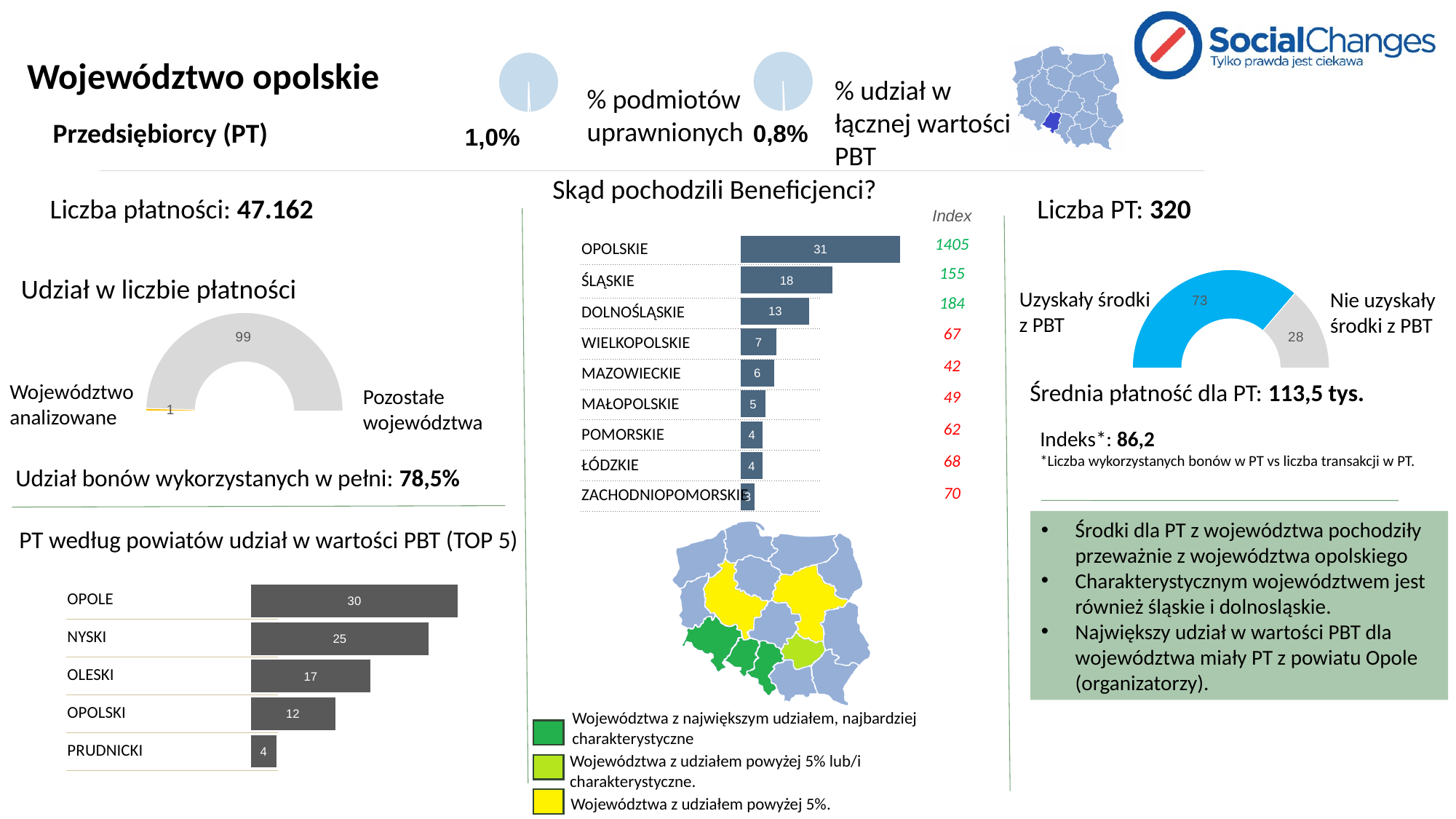
In the 'Skąd pochodzili Beneficjenci?' chart, what is the Index value shown for OPOLSKIE? 1405 In the doughnut chart under 'Liczba PT: 320', what is the value for 'Uzyskały środki z PBT'? 73 In the 'Skąd pochodzili Beneficjenci?' chart, what is the difference between the values for ŚLĄSKIE and DOLNOŚLĄSKIE? 5 In the 'Skąd pochodzili Beneficjenci?' chart, which voivodeship has the highest value? OPOLSKIE In the 'Skąd pochodzili Beneficjenci?' chart, how many voivodeships are listed? 9 In the 'Skąd pochodzili Beneficjenci?' chart, what is the value for OPOLSKIE? 31 In the 'PT według powiatów udział w wartości PBT (TOP 5)' chart, which powiat has the lowest value? PRUDNICKI In the 'PT według powiatów udział w wartości PBT (TOP 5)' chart, which is larger, OLESKI or OPOLSKI? OLESKI In the 'PT według powiatów udział w wartości PBT (TOP 5)' chart, what is the value for NYSKI? 25 In the 'Udział w liczbie płatności' chart, what is the value for 'Pozostałe województwa'? 99 What kind of chart is 'PT według powiatów udział w wartości PBT (TOP 5)'? Bar chart In the 'PT według powiatów udział w wartości PBT (TOP 5)' chart, what is the difference between OPOLE and OPOLSKI? 18